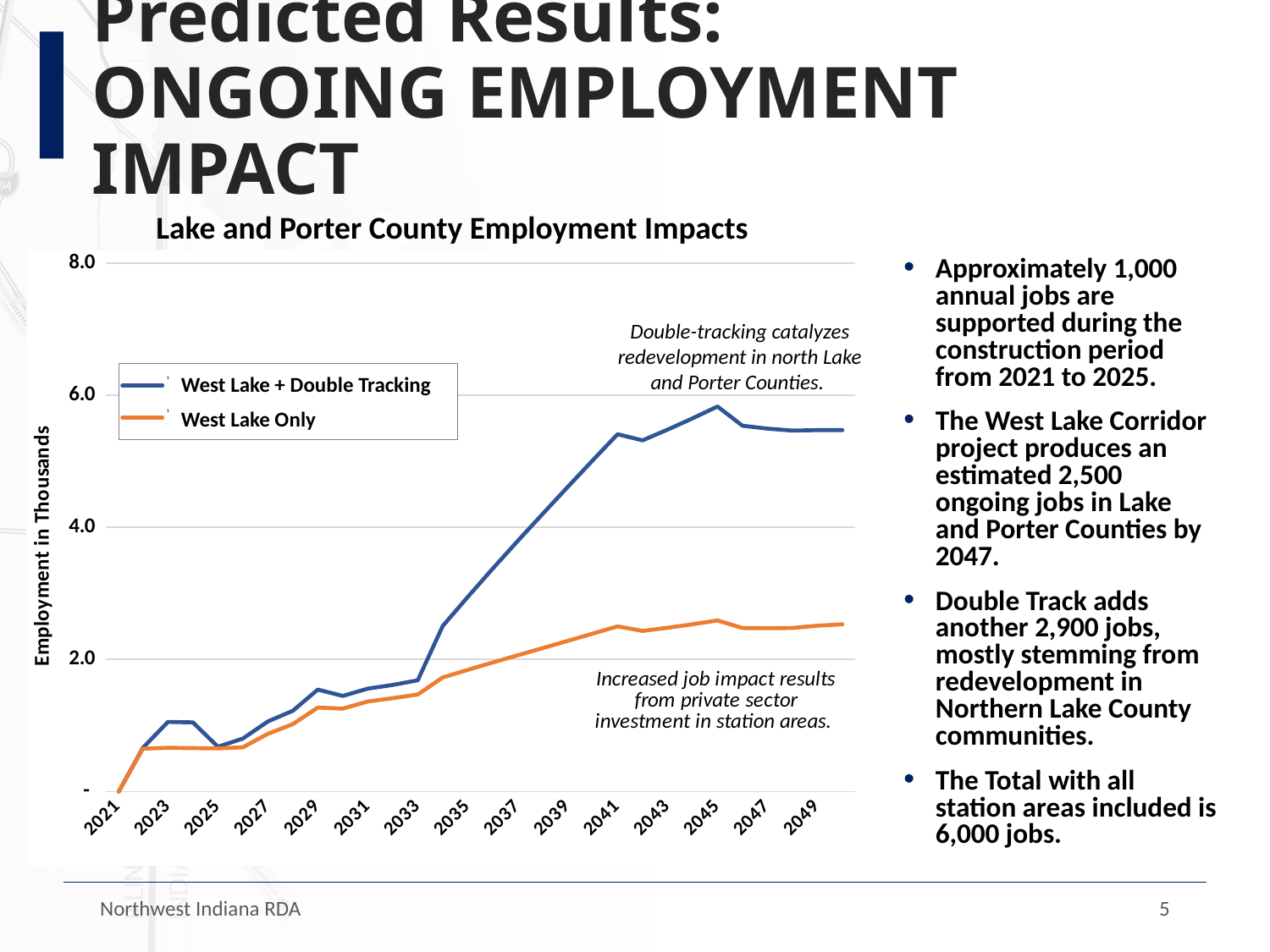
Does the West Lake Only series generally rise or fall from 2021 to 2045? rise What is the label on the chart's vertical axis? Employment in Thousands Is the value for West Lake Only in 2049 greater or less than 2.0? greater What is the title of the chart? Lake and Porter County Employment Impacts In 2045, which series has the higher value, West Lake + Double Tracking or West Lake Only? West Lake + Double Tracking Is the value for West Lake + Double Tracking in 2049 greater or less than 6.0? less Is the value for West Lake Only in 2045 greater or less than 4.0? less What kind of chart is shown on the slide? line chart How many series does the chart legend list? 2 How many year labels are shown along the x axis? 15